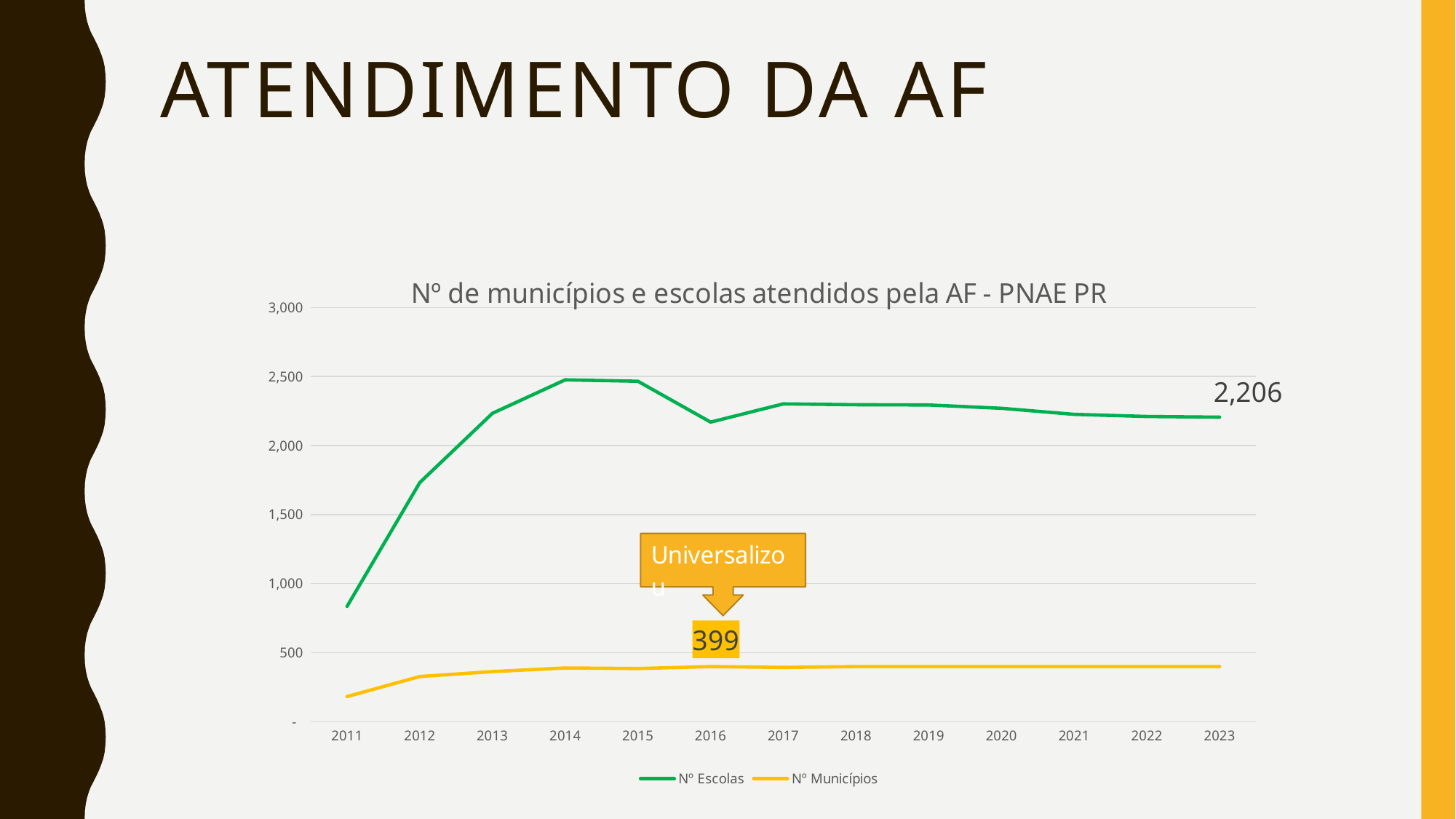
What is the value of Nº Escolas in 2023? 2,206 Is the value for Nº Municípios in 2011 greater or less than 500? less Does Nº Escolas rise or fall from 2011 to 2014? rise In which year is Nº Escolas lowest? 2011 Is the value for Nº Escolas in 2011 greater or less than 1,000? less What is the title of the chart? Nº de municípios e escolas atendidos pela AF - PNAE PR How many years are shown on the x axis? 13 What kind of chart is shown on the slide? line chart In 2023, which series has the larger value, Nº Escolas or Nº Municípios? Nº Escolas How many series does the legend list? 2 What value is shown in the yellow callout label for Nº Municípios? 399 Is the value for Nº Escolas in 2014 greater or less than 2,000? greater